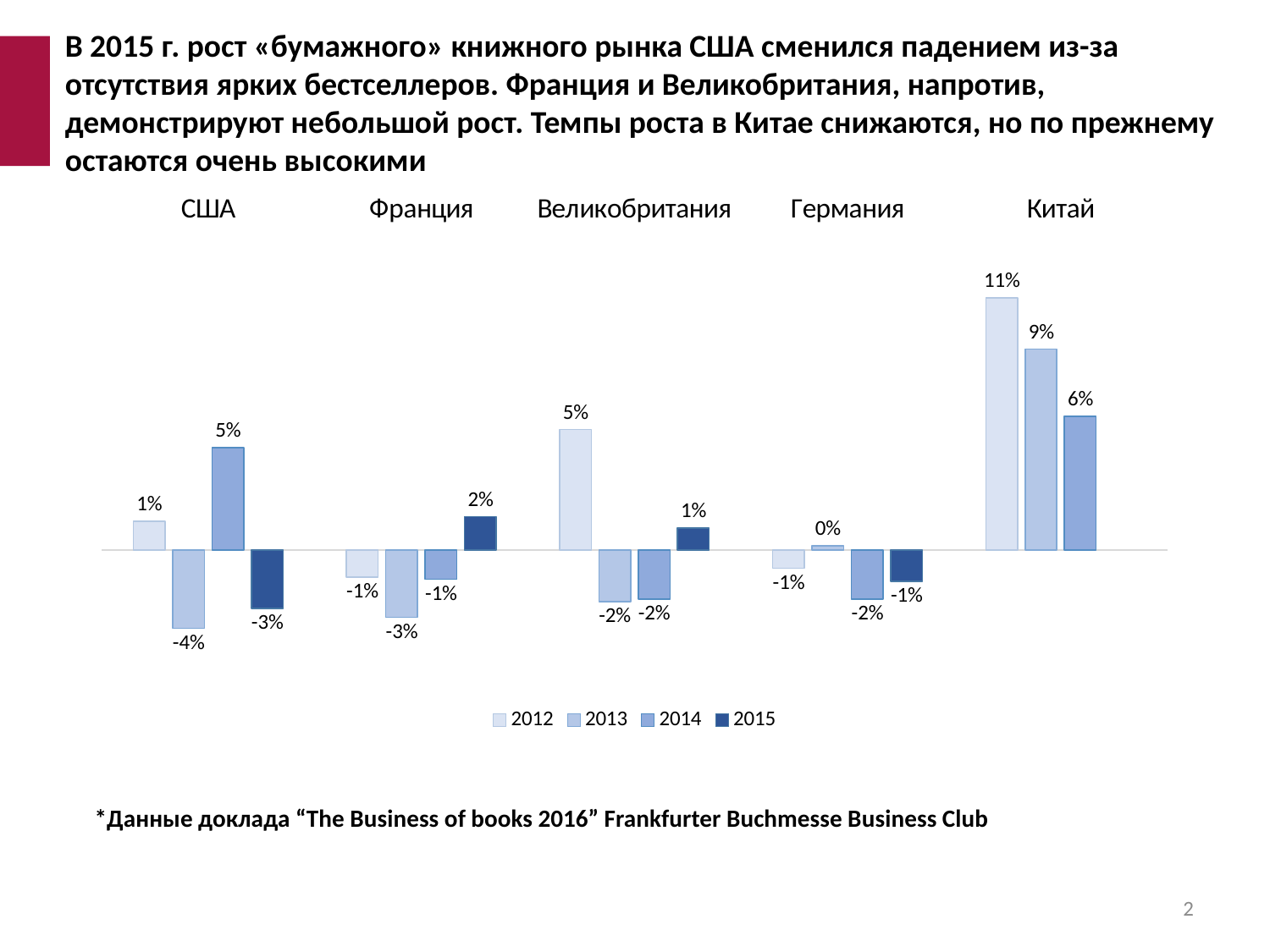
What is the value for США in 2014? 5% What is the value for Франция in 2015? 2% What is the value for США in 2013? -4% Which is larger, the 2015 value for Франция or the 2015 value for Великобритания? Франция What is the value for Великобритания in 2012? 5% What is the difference between the 2014 and 2015 values for США? 8 percentage points Which country has the highest value on the chart? Китай What is the lowest value shown on the chart? -4% How many countries are shown on the chart? 5 What kind of chart is shown on the slide? Bar chart How many series does the legend list? 4 What is the value for Германия in 2013? 0%